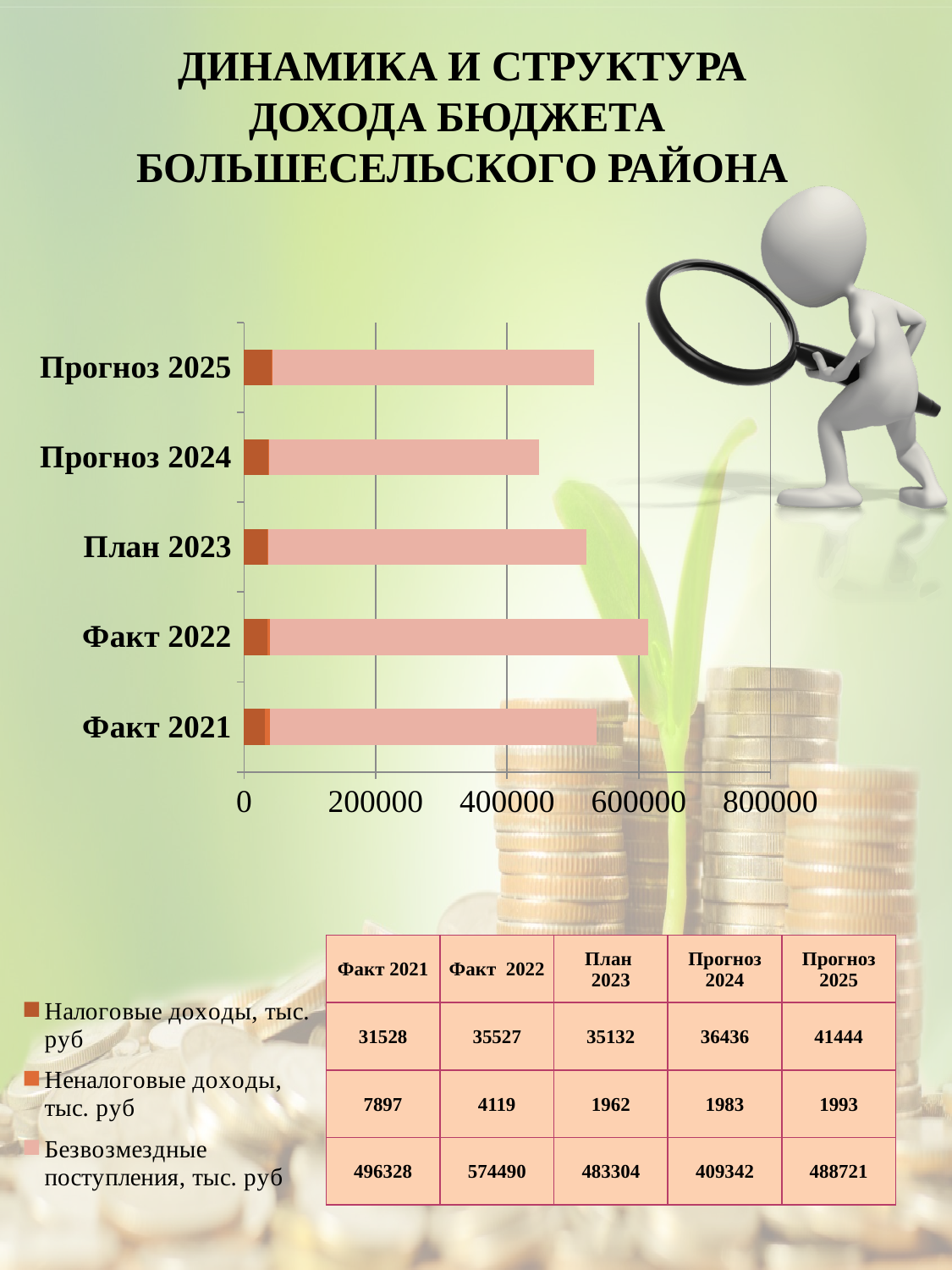
Which is larger: Безвозмездные поступления for План 2023 or for Прогноз 2025? Прогноз 2025 What is the difference between Налоговые доходы for Прогноз 2025 and Прогноз 2024? 5008 What is the value of Безвозмездные поступления for Факт 2022? 574490 How many series does the legend list? 3 What is the value of Неналоговые доходы for План 2023? 1962 Is the total bar for Прогноз 2024 greater or less than 600000? less What is the value of Налоговые доходы for Факт 2021? 31528 How many categories are plotted on the chart? 5 What is the total of the stacked bar for Факт 2022? 614136 What kind of chart is shown on the slide? Stacked bar chart Which category has the highest value of Безвозмездные поступления? Факт 2022 Which category has the lowest value of Неналоговые доходы? План 2023